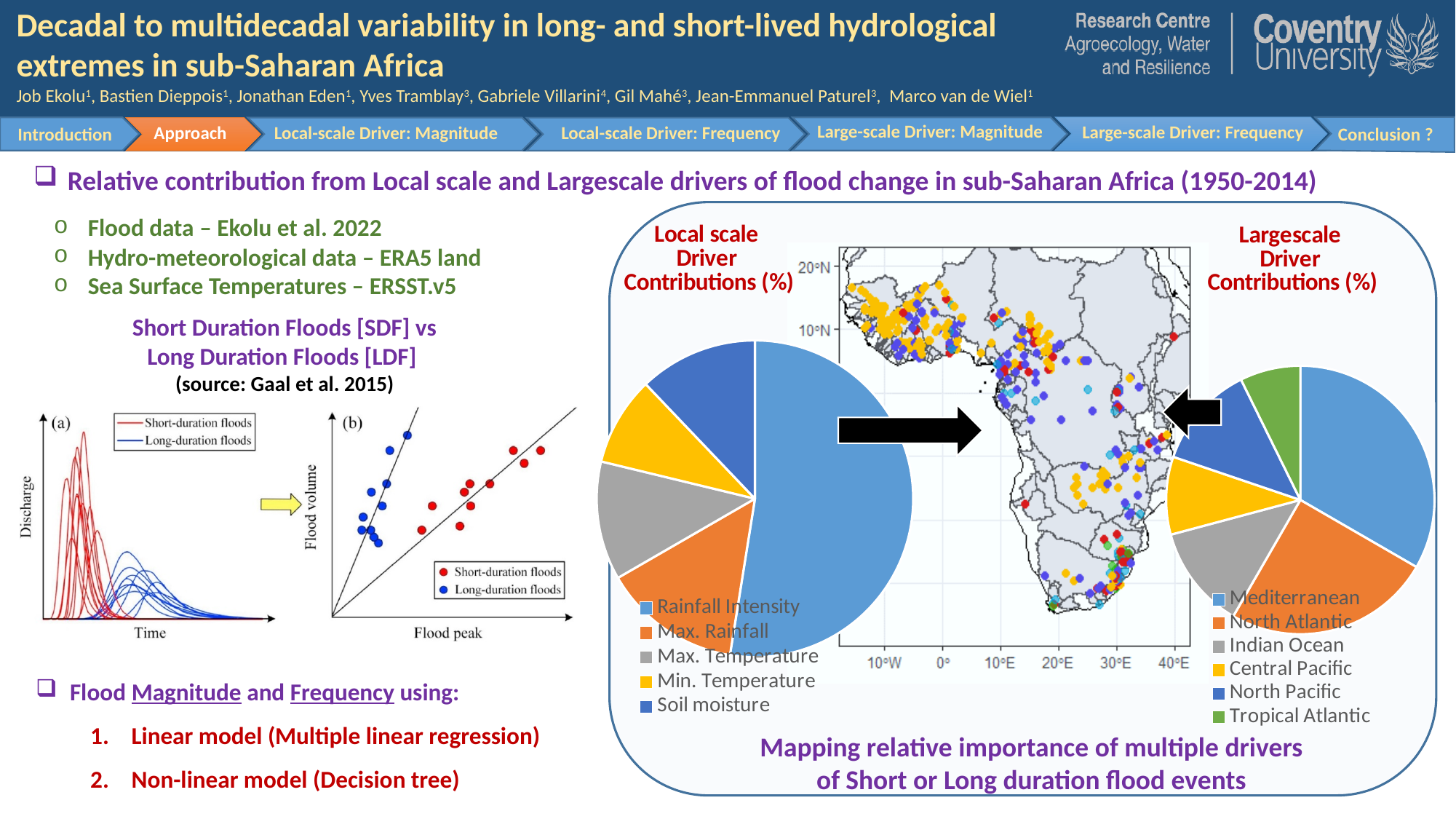
In the 'Local scale Driver Contributions (%)' pie chart, which driver has the largest slice? Rainfall Intensity What kind of chart is panel (b) of the Short Duration Floods vs Long Duration Floods figure, which plots Flood volume against Flood peak? scatter plot In the 'Largescale Driver Contributions (%)' pie chart, which slice is larger: North Atlantic or Tropical Atlantic? North Atlantic How many categories does the legend of the 'Largescale Driver Contributions (%)' pie chart list? 6 In the 'Largescale Driver Contributions (%)' pie chart, what colour is the Tropical Atlantic slice? green In the 'Largescale Driver Contributions (%)' pie chart, which driver has the smallest slice? Tropical Atlantic How many categories does the legend of the 'Local scale Driver Contributions (%)' pie chart list? 5 How many series does the legend of panel (b) (Flood volume vs Flood peak) list? 2 In the 'Largescale Driver Contributions (%)' pie chart, which driver has the largest slice? Mediterranean In the 'Local scale Driver Contributions (%)' pie chart, what colour is the Max. Rainfall slice? orange In the 'Local scale Driver Contributions (%)' pie chart, which slice is larger: Rainfall Intensity or Soil moisture? Rainfall Intensity What kind of chart is the 'Local scale Driver Contributions (%)' chart? pie chart